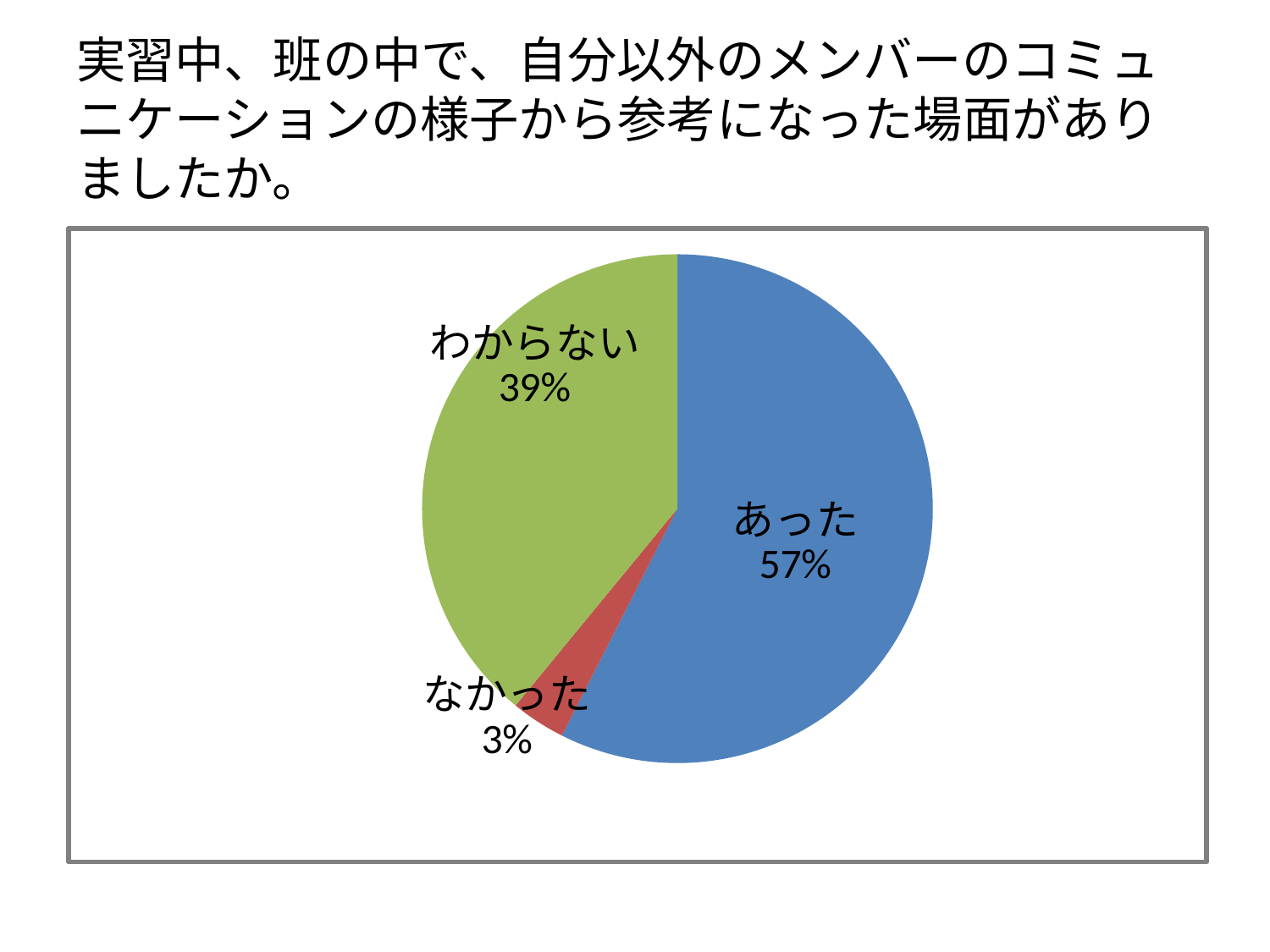
What share of the pie does なかった represent? 3% What is the difference in percentage points between わからない and なかった? 36 Which category has the largest slice of the pie? あった Which is larger, the slice for わからない or the slice for なかった? わからない What share of the pie does あった represent? 57% What colour is the slice for なかった? red Which category has the smallest slice of the pie? なかった What is the difference in percentage points between あった and わからない? 18 What share of the pie does わからない represent? 39% What colour is the slice for あった? blue What kind of chart is shown on the slide? pie chart How many slices does the pie chart have? 3